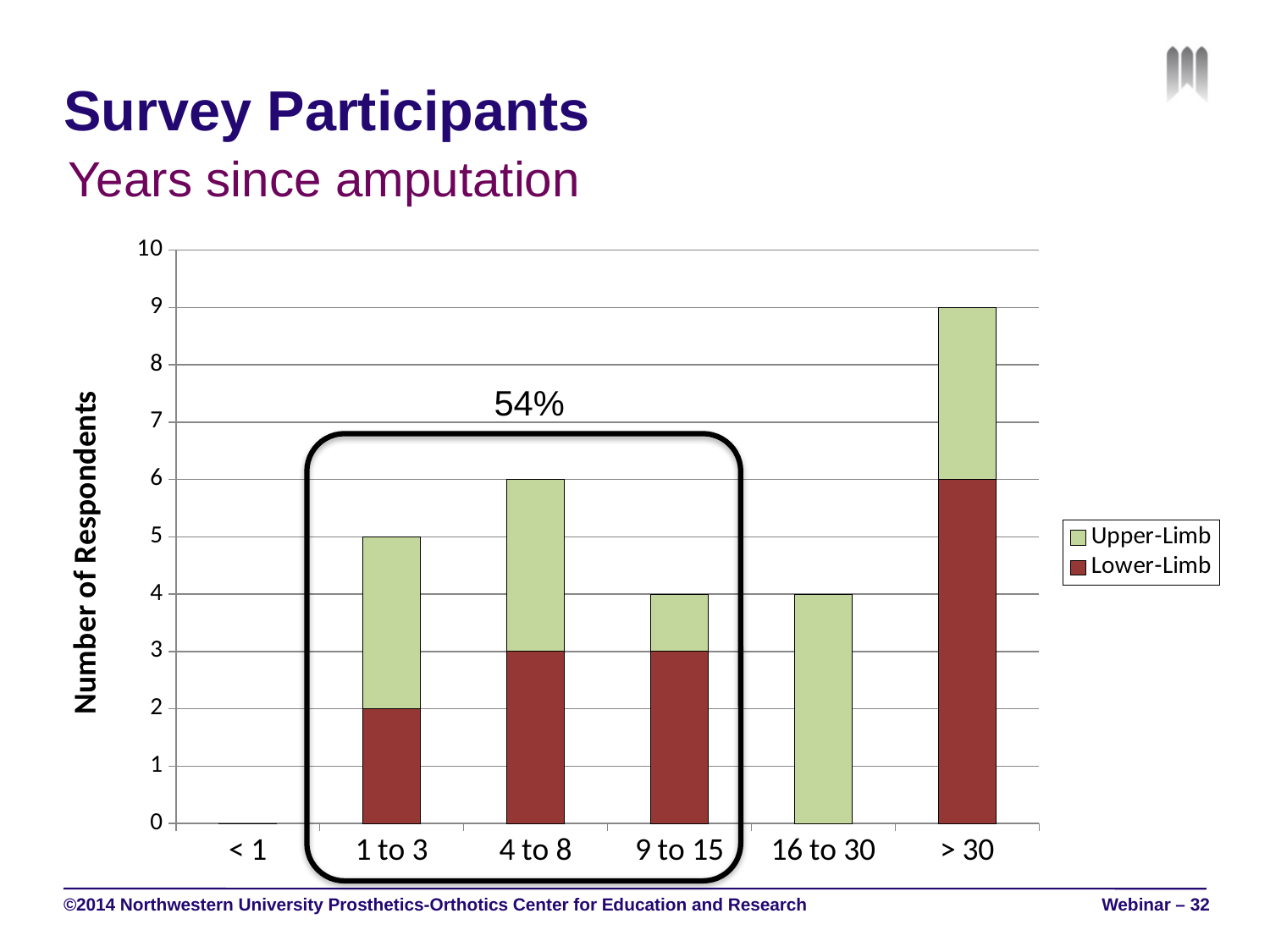
How many Lower-Limb respondents are in the > 30 category? 6 How many Upper-Limb respondents are in the 16 to 30 category? 4 What is the difference between the total for > 30 and the total for 16 to 30? 5 Which is larger, the total bar for 1 to 3 or the total bar for 9 to 15? 1 to 3 What is the total number of respondents in the 4 to 8 category? 6 What is the total number of respondents in the > 30 category? 9 How many Lower-Limb respondents are in the 1 to 3 category? 2 How many categories are shown on the x axis? 6 What kind of chart is shown on the slide? Stacked bar chart Which category has the tallest total bar? > 30 How many series does the legend list? 2 What percentage is printed above the boxed group of bars? 54%